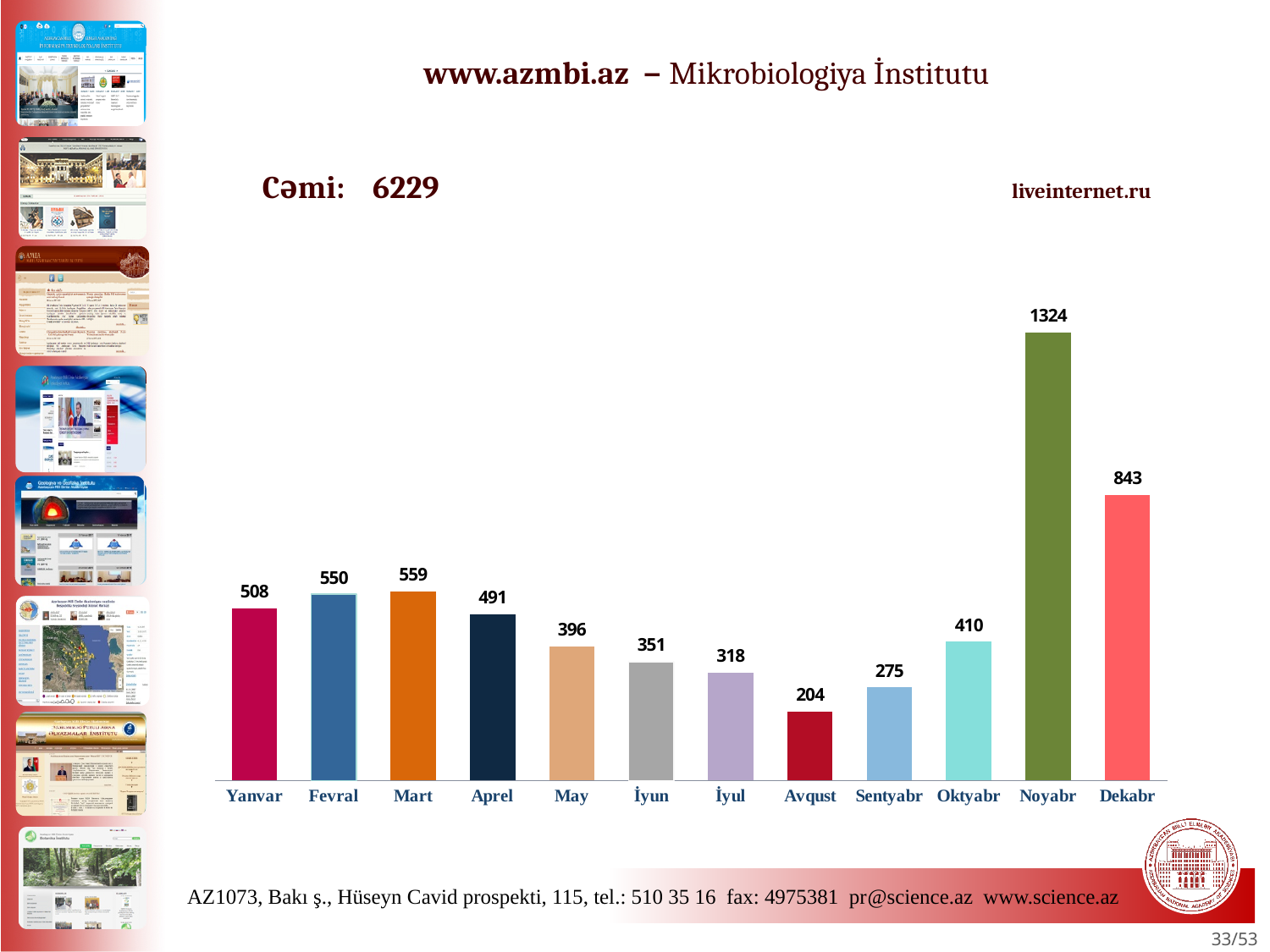
What is the value for Mart? 559 What is the difference between the values for Noyabr and Dekabr? 481 What is the value for Noyabr? 1324 Which is larger, the value for Oktyabr or the value for May? Oktyabr Which month has the highest value? Noyabr What is the value for Avqust? 204 Do the values rise or fall from May to Avqust? fall What kind of chart is shown on the slide? bar chart How many months are shown on the chart? 12 What is the difference between the values for Fevral and Yanvar? 42 Which month has the lowest value? Avqust What total (Cəmi) is printed above the chart? 6229